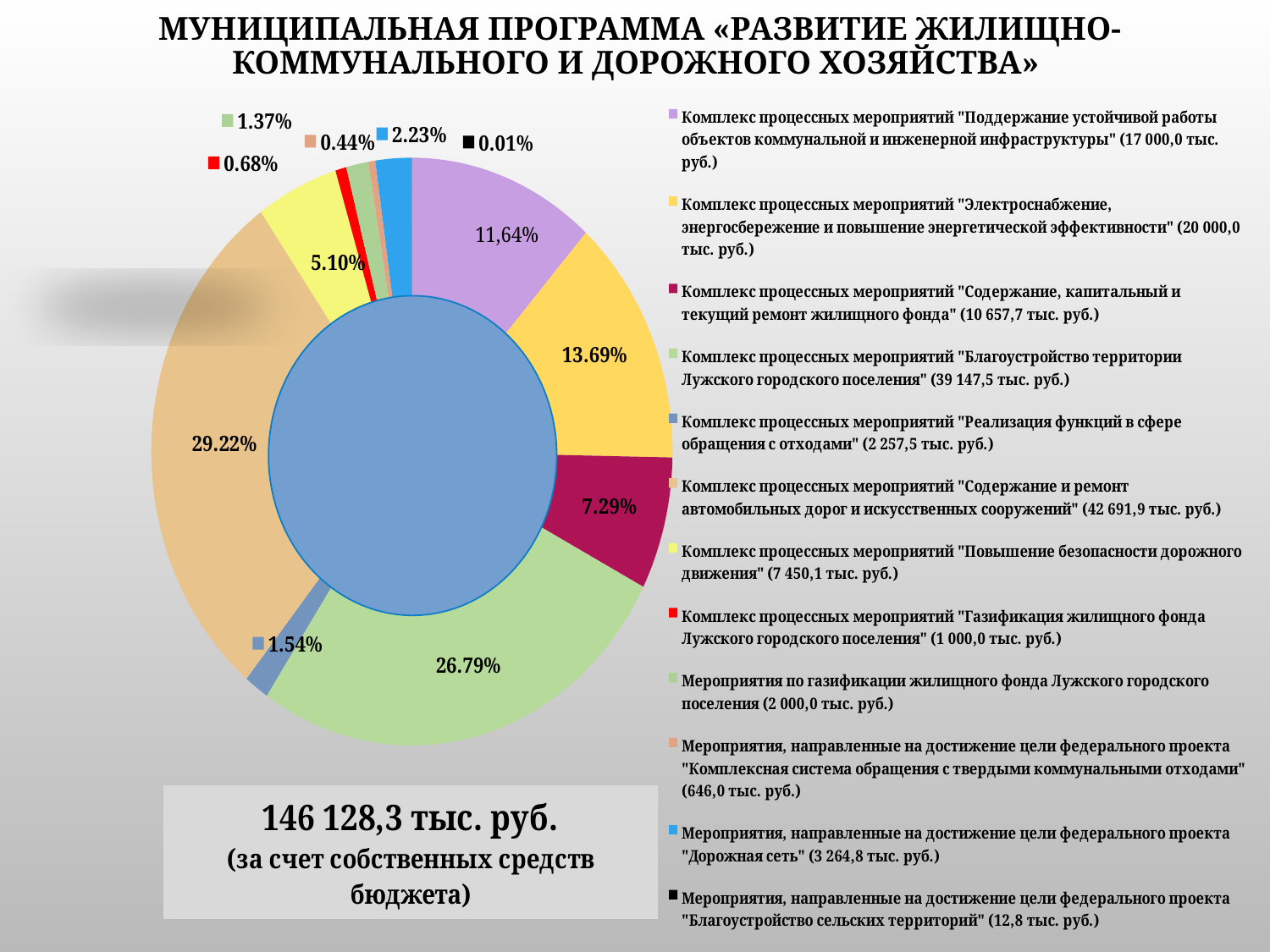
What is the difference in percentage points between the 29.22% slice and the 26.79% slice? 2.43 Which category has the largest share of the pie? Содержание и ремонт автомобильных дорог и искусственных сооружений What total amount is shown in the box below the pie chart? 146 128,3 тыс. руб. What share is shown for the slice "Благоустройство территории Лужского городского поселения"? 26.79% What kind of chart is shown on the slide? Doughnut (ring) chart What share is shown for the slice "Содержание, капитальный и текущий ремонт жилищного фонда"? 7.29% What amount in thousand rubles is given in the legend for "Газификация жилищного фонда Лужского городского поселения"? 1 000,0 тыс. руб. Which category has the smallest share of the pie? Благоустройство сельских территорий How many slices does the pie chart have? 12 What share is shown for the slice "Электроснабжение, энергосбережение и повышение энергетической эффективности"? 13.69% What is the share of the largest slice in the pie chart? 29.22% Which slice is larger: "Повышение безопасности дорожного движения" or "Дорожная сеть"? Повышение безопасности дорожного движения